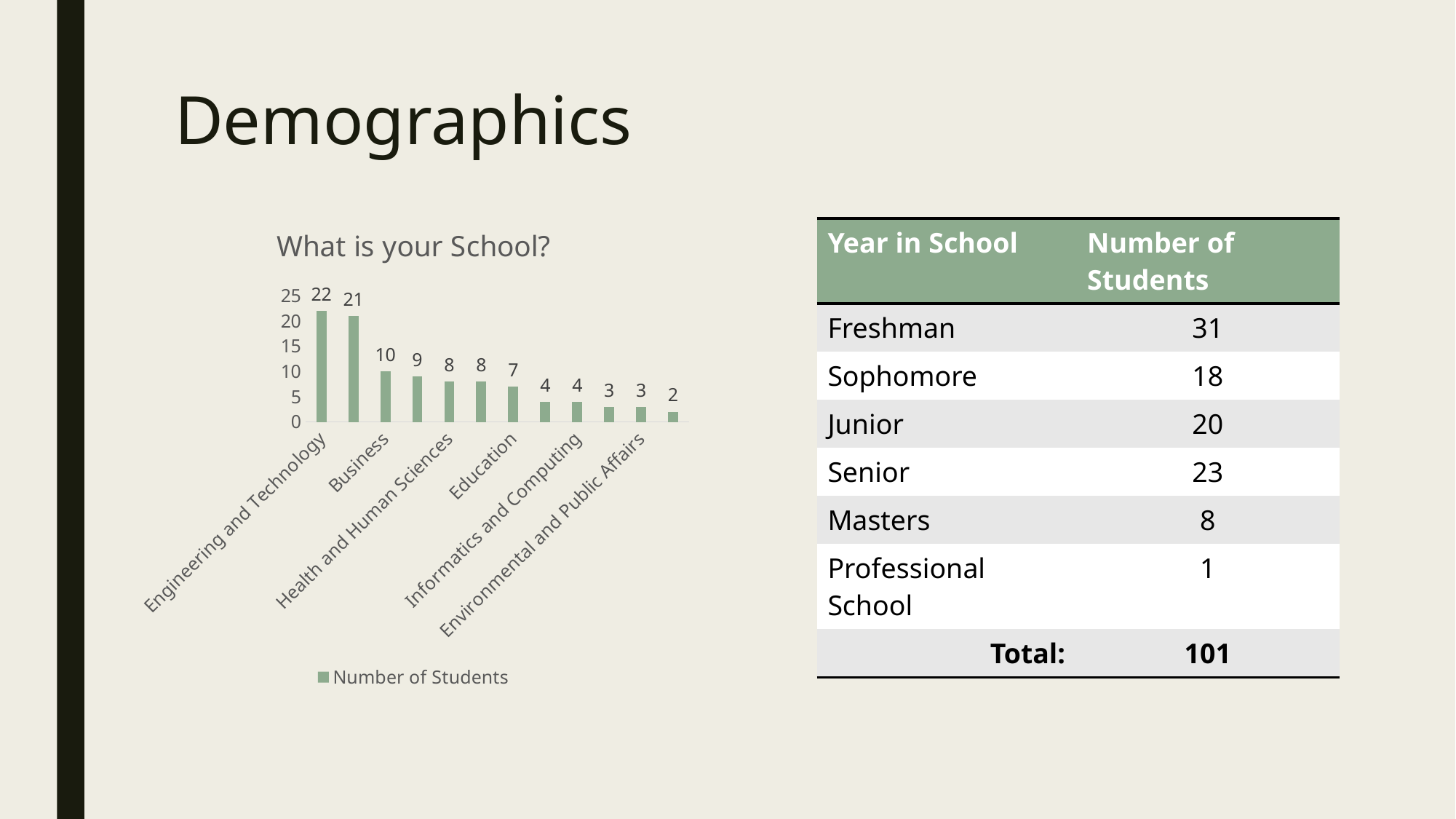
What type of chart is shown on the slide? bar chart What is the number of students for Engineering and Technology? 22 Do the bar values rise or fall from left to right along the x axis? fall What is the difference between the highest and lowest values in the chart? 20 Is the value for Engineering and Technology greater or less than 20? greater What is the title of the chart? What is your School? How many bars are plotted in the chart? 12 How many series does the chart legend list? 1 What is the lowest value shown in the chart? 2 What series name appears in the chart legend? Number of Students Which is larger, the first bar (Engineering and Technology) or the second bar? Engineering and Technology What is the highest value shown in the chart? 22